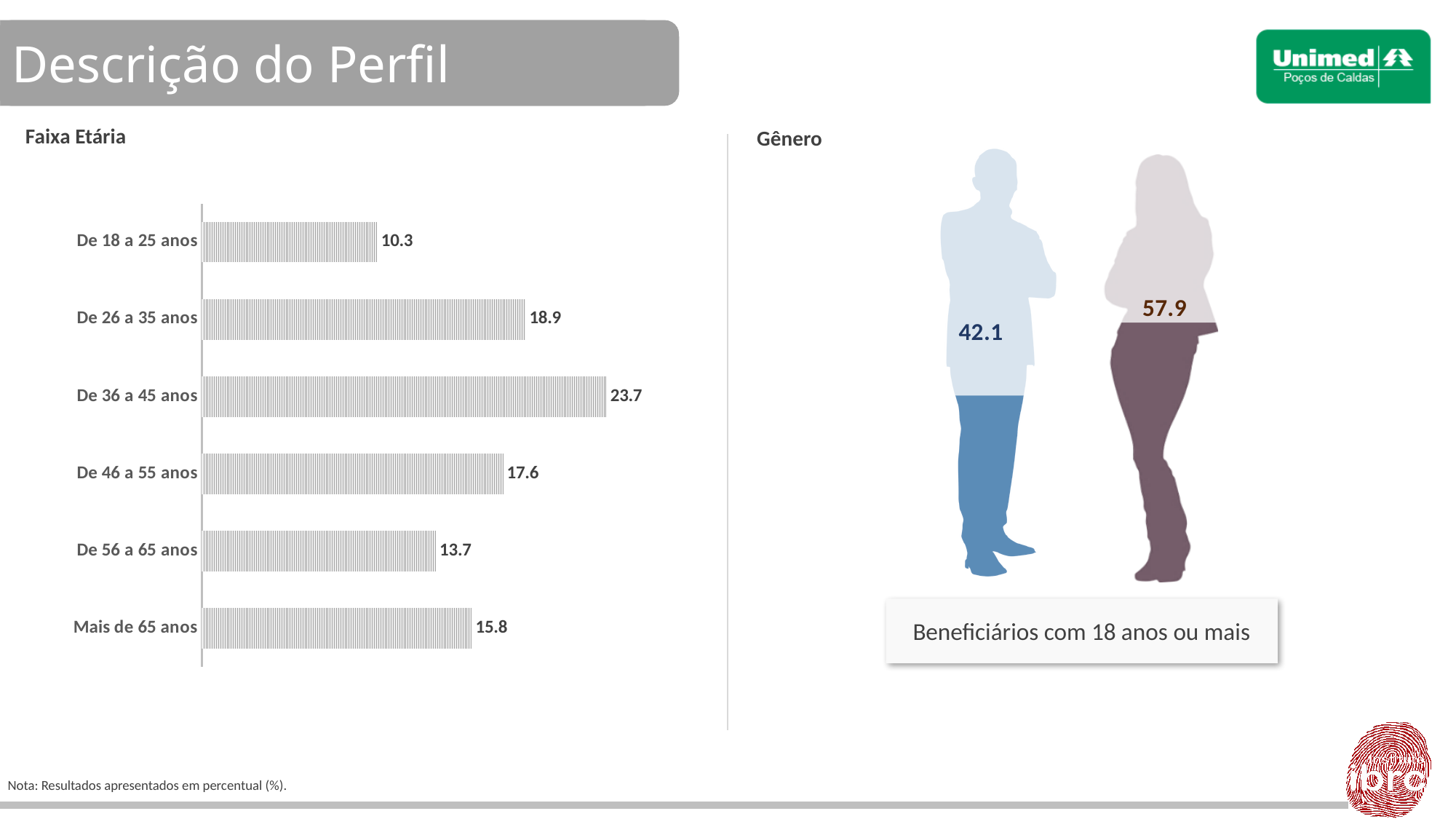
In the Faixa Etária chart, which age group has the highest value? De 36 a 45 anos In the Faixa Etária chart, what is the value for Mais de 65 anos? 15.8 In the Faixa Etária chart, what is the value for De 36 a 45 anos? 23.7 How many age groups are shown in the Faixa Etária chart? 6 In the Gênero graphic, what is the difference between the female and male values? 15.8 In the Faixa Etária chart, which is larger: De 56 a 65 anos or Mais de 65 anos? Mais de 65 anos In the Gênero graphic, what is the value shown for the male figure? 42.1 What kind of chart is the Faixa Etária chart? Bar chart In the Gênero graphic, what is the value shown for the female figure? 57.9 In the Faixa Etária chart, what is the value for De 18 a 25 anos? 10.3 In the Faixa Etária chart, which age group has the lowest value? De 18 a 25 anos In the Faixa Etária chart, what is the difference between De 26 a 35 anos and De 46 a 55 anos? 1.3